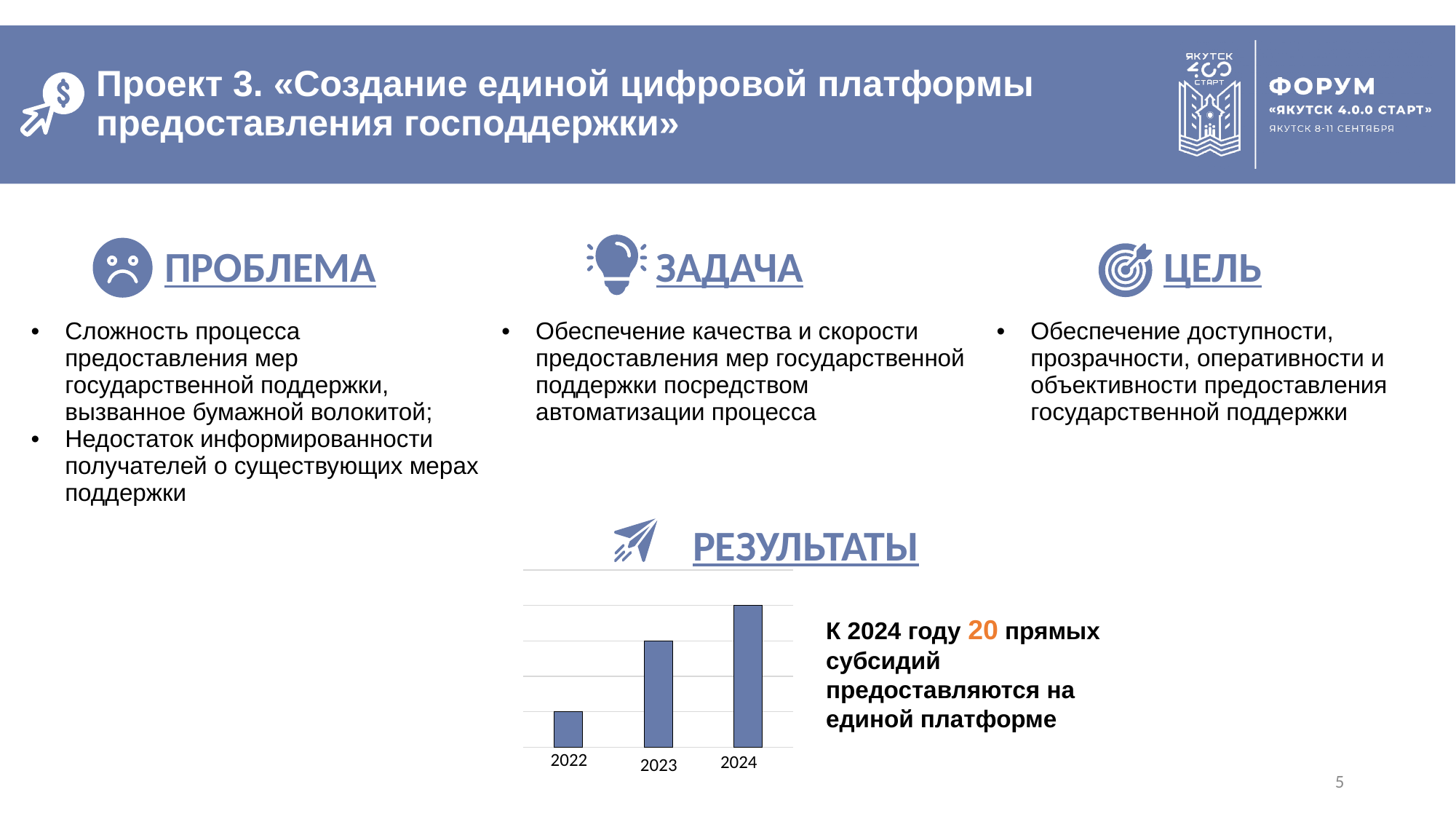
What is the first year shown on the x axis of the chart? 2022 Which bar is taller, 2023 or 2024? 2024 Which year has the tallest bar in the chart? 2024 Which bar is taller, 2022 or 2023? 2023 Do the bar values rise or fall from 2022 to 2024? rise What are the category labels on the x axis of the chart? 2022, 2023, 2024 What kind of chart is shown under the heading РЕЗУЛЬТАТЫ? bar chart Which year has the shortest bar in the chart? 2022 How many bars does the chart under РЕЗУЛЬТАТЫ have? 3